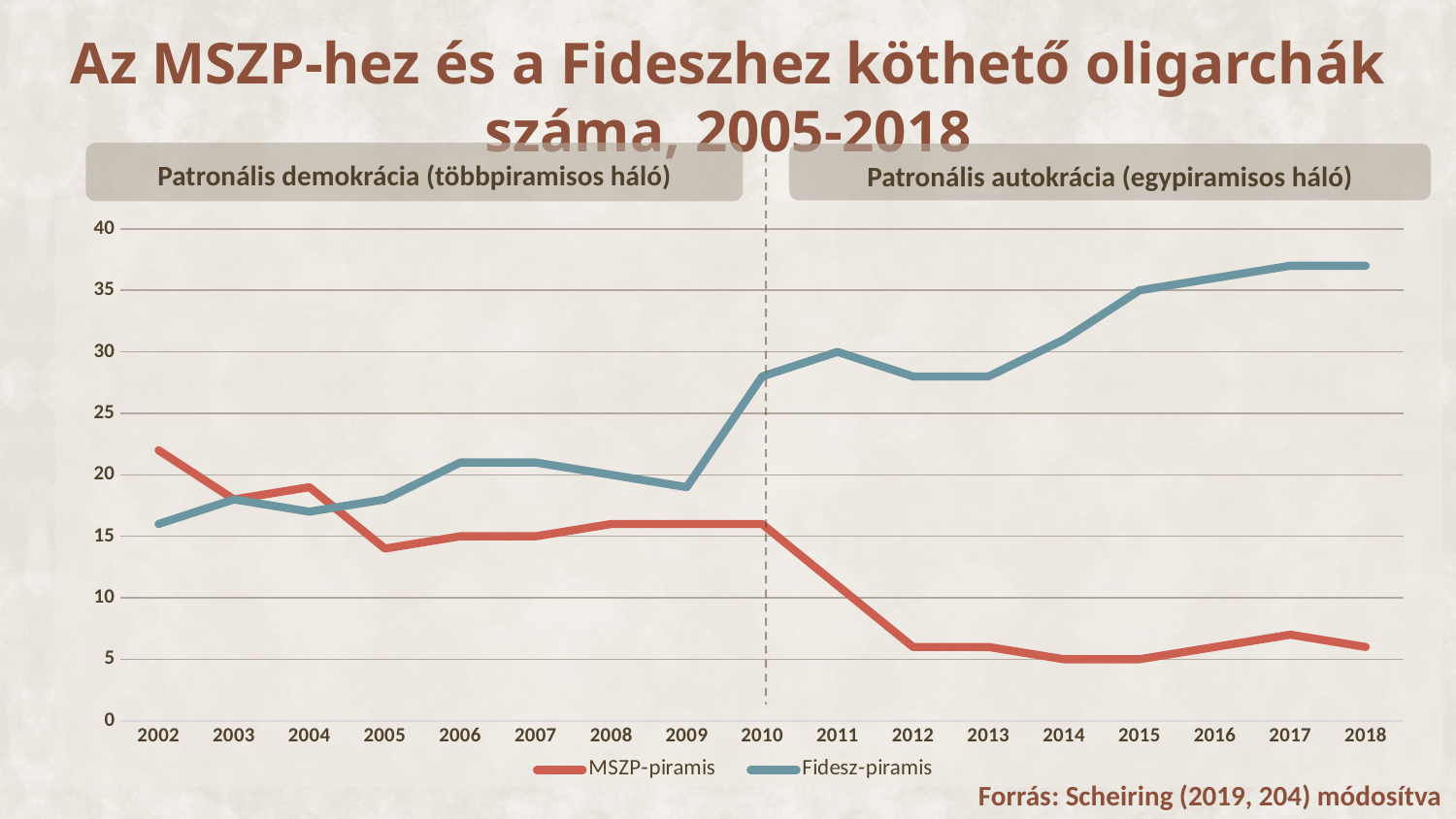
What is the value of the Fidesz-piramis series in 2011? 30 How many series does the legend list? 2 How many years are plotted along the x axis? 17 In which year does the MSZP-piramis series reach its highest value? 2002 Is the value for MSZP-piramis in 2002 greater or less than 20? greater Is the value for Fidesz-piramis in 2018 greater or less than 35? greater In 2018, which series has the larger value, MSZP-piramis or Fidesz-piramis? Fidesz-piramis Is the value for MSZP-piramis in 2012 greater or less than 10? less What kind of chart is shown on the slide? line chart What is the value of the Fidesz-piramis series in 2015? 35 What is the value of the MSZP-piramis series in 2014? 5 Does the Fidesz-piramis series rise or fall between 2013 and 2017? rise